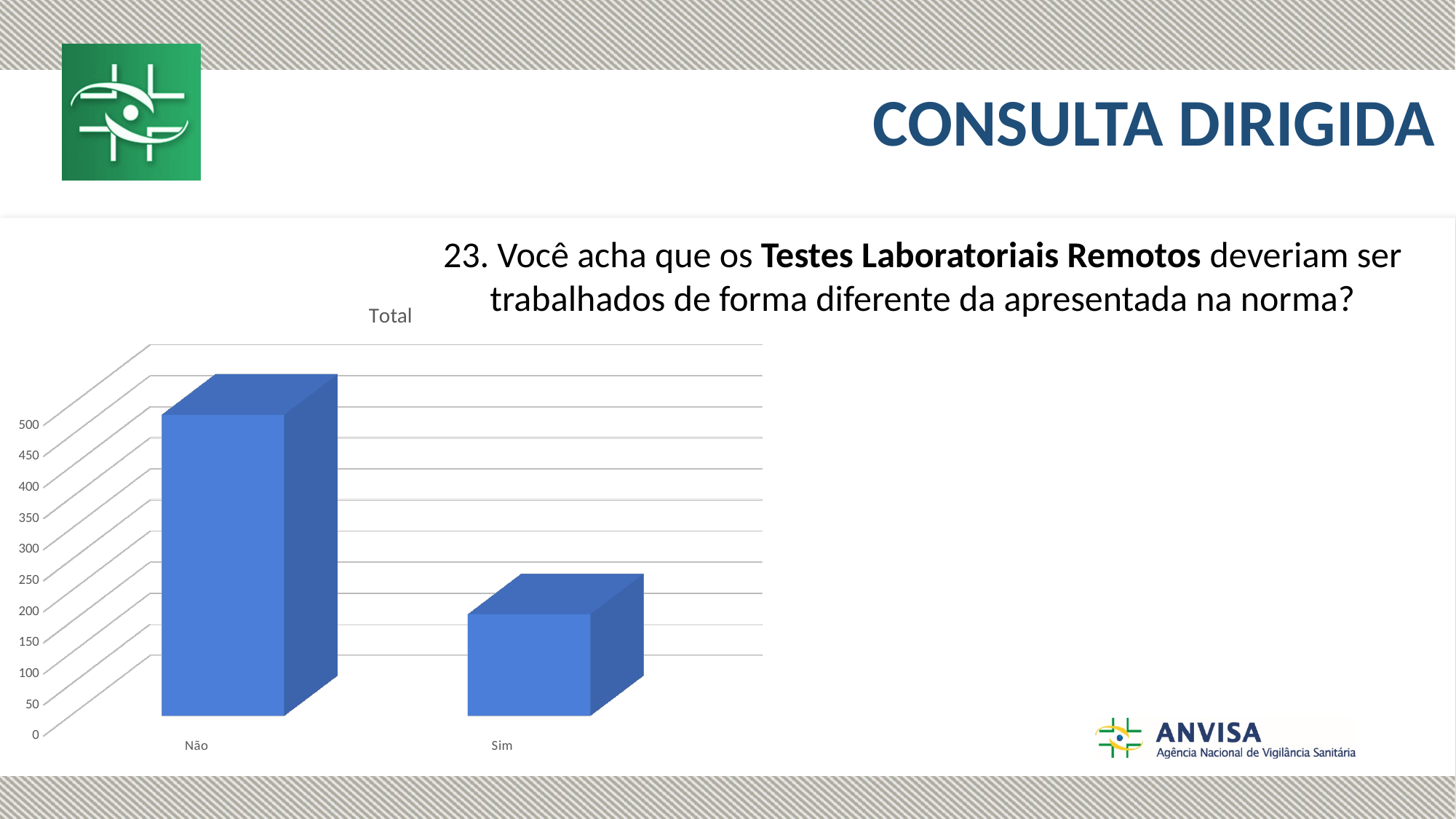
Is the value for Sim greater or less than 250? less What is the highest value labelled on the vertical axis of the chart? 500 What is the title of the chart? Total How many categories are shown on the x axis of the chart? 2 Is the value for Sim greater or less than 100? greater Is the value for Não greater or less than 300? greater Which category has the lowest value in the chart? Sim Which is larger, the value for Não or the value for Sim? Não What kind of chart is shown on the slide? bar chart Which category has the highest value in the chart? Não Do the values rise or fall from Não to Sim along the x axis? fall